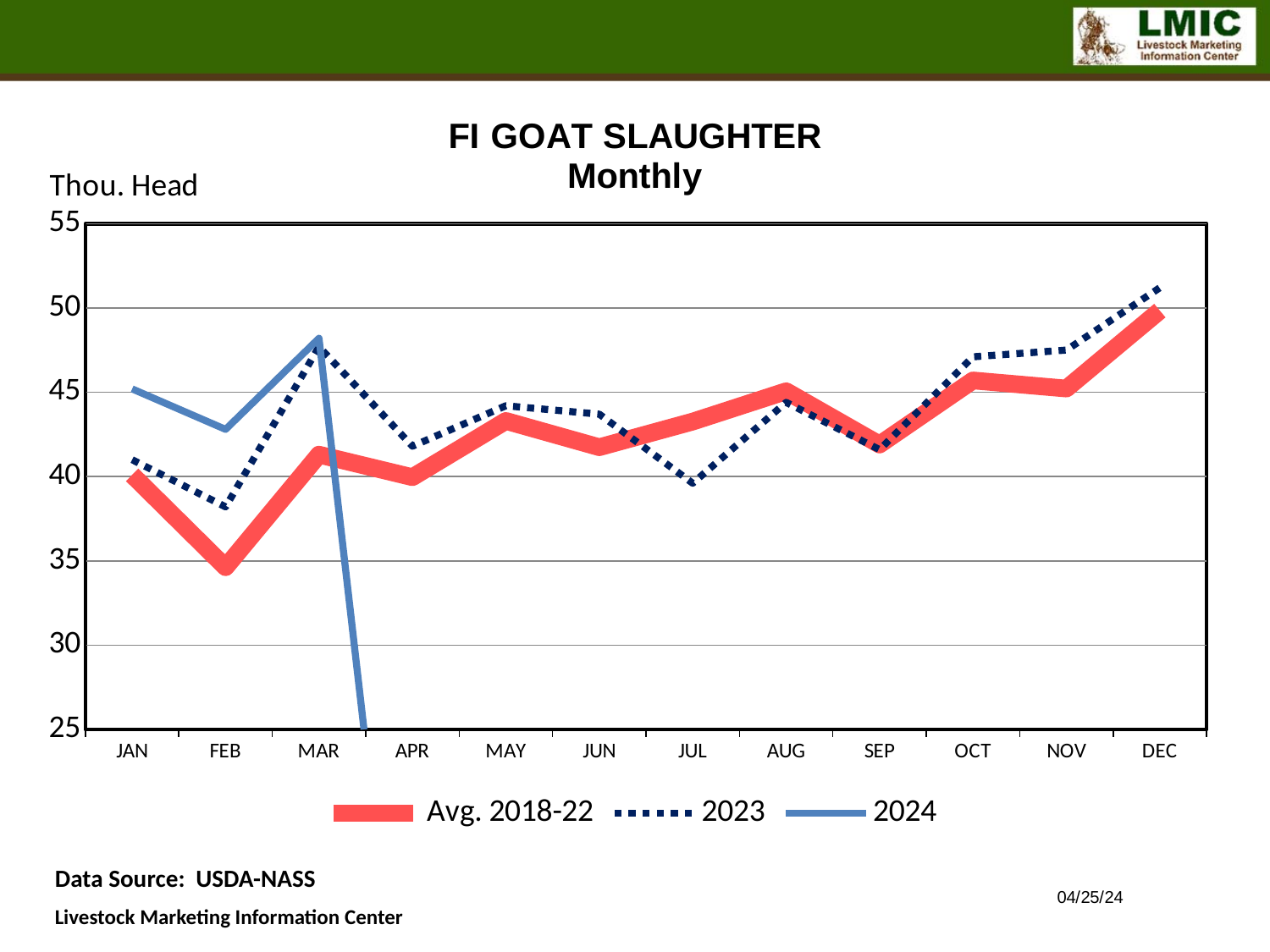
How many months are shown along the x axis? 12 Is the value for 2023 in JUL greater or less than 40? less In which month does the 2023 series reach its highest value? DEC In which month is the Avg. 2018-22 series at its lowest? FEB In which month does the 2024 series reach its highest value? MAR How many series does the legend list? 3 Does the 2023 series rise or fall from SEP to DEC? rise What kind of chart is shown on the slide? line chart What unit is given for the y axis? Thou. Head Is the value for 2023 in DEC greater or less than 50? greater In FEB, which is larger: the 2024 value or the Avg. 2018-22 value? 2024